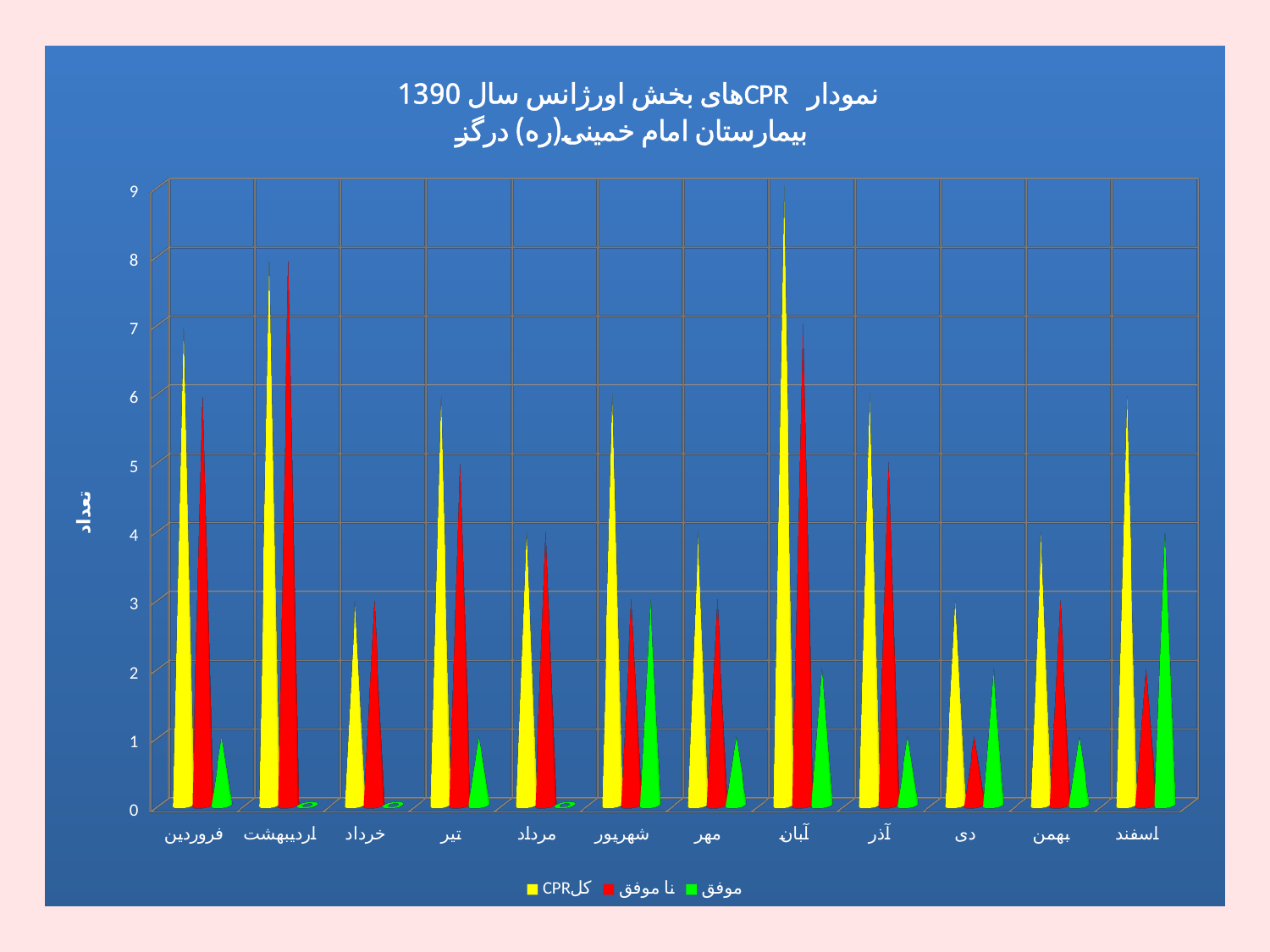
Which month has the highest value for کل CPR? آبان Is the value for موفق in اسفند greater or less than 3? greater What is the title of the y axis? تعداد How many months (categories) are shown on the x axis? 12 How many series does the legend list? 3 What kind of chart is shown on the slide? bar chart Is the value for کل CPR in آبان greater or less than 8? greater Which is larger: نا موفق in اردیبهشت or نا موفق in فروردین? اردیبهشت Which month has the highest value for نا موفق? اردیبهشت Is the value for نا موفق in دی greater or less than 2? less Which month has the highest value for موفق? اسفند Which is larger: کل CPR in آبان or کل CPR in اردیبهشت? آبان